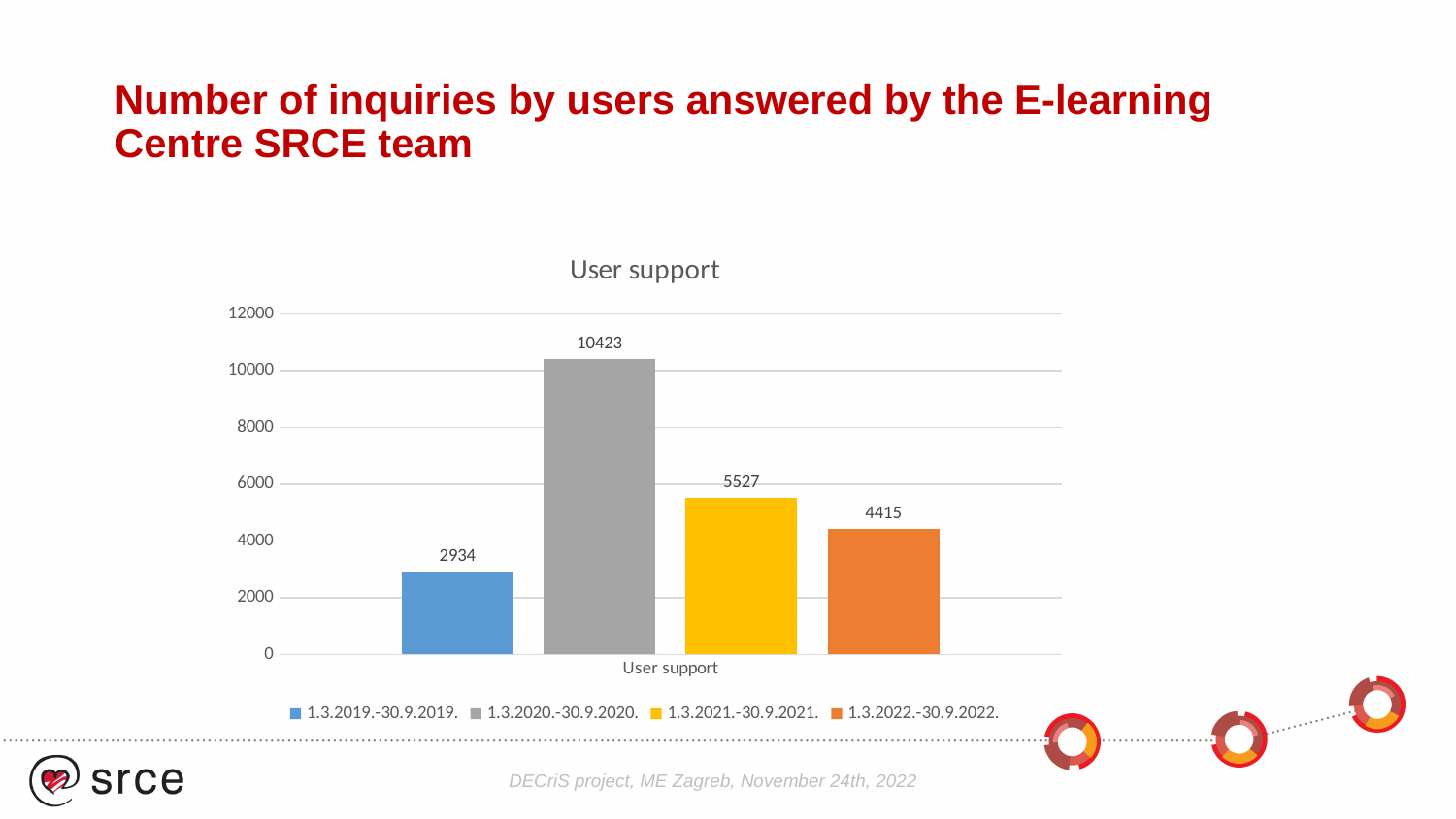
What is the value for the 1.3.2022.-30.9.2022. series in the User support chart? 4415 Which is larger, the value for 1.3.2021.-30.9.2021. or the value for 1.3.2022.-30.9.2022.? 1.3.2021.-30.9.2021. How many series does the legend list in the User support chart? 4 Which series has the highest value in the User support chart? 1.3.2020.-30.9.2020. Which series has the lowest value in the User support chart? 1.3.2019.-30.9.2019. What kind of chart is shown on the slide? bar chart What is the value for the 1.3.2019.-30.9.2019. series in the User support chart? 2934 Is the value for 1.3.2020.-30.9.2020. greater or less than 10000? greater What is the value for the 1.3.2020.-30.9.2020. series in the User support chart? 10423 What is the title of the chart on the slide? User support What is the difference between the 1.3.2021.-30.9.2021. value and the 1.3.2022.-30.9.2022. value? 1112 What is the difference between the 1.3.2020.-30.9.2020. value and the 1.3.2021.-30.9.2021. value? 4896